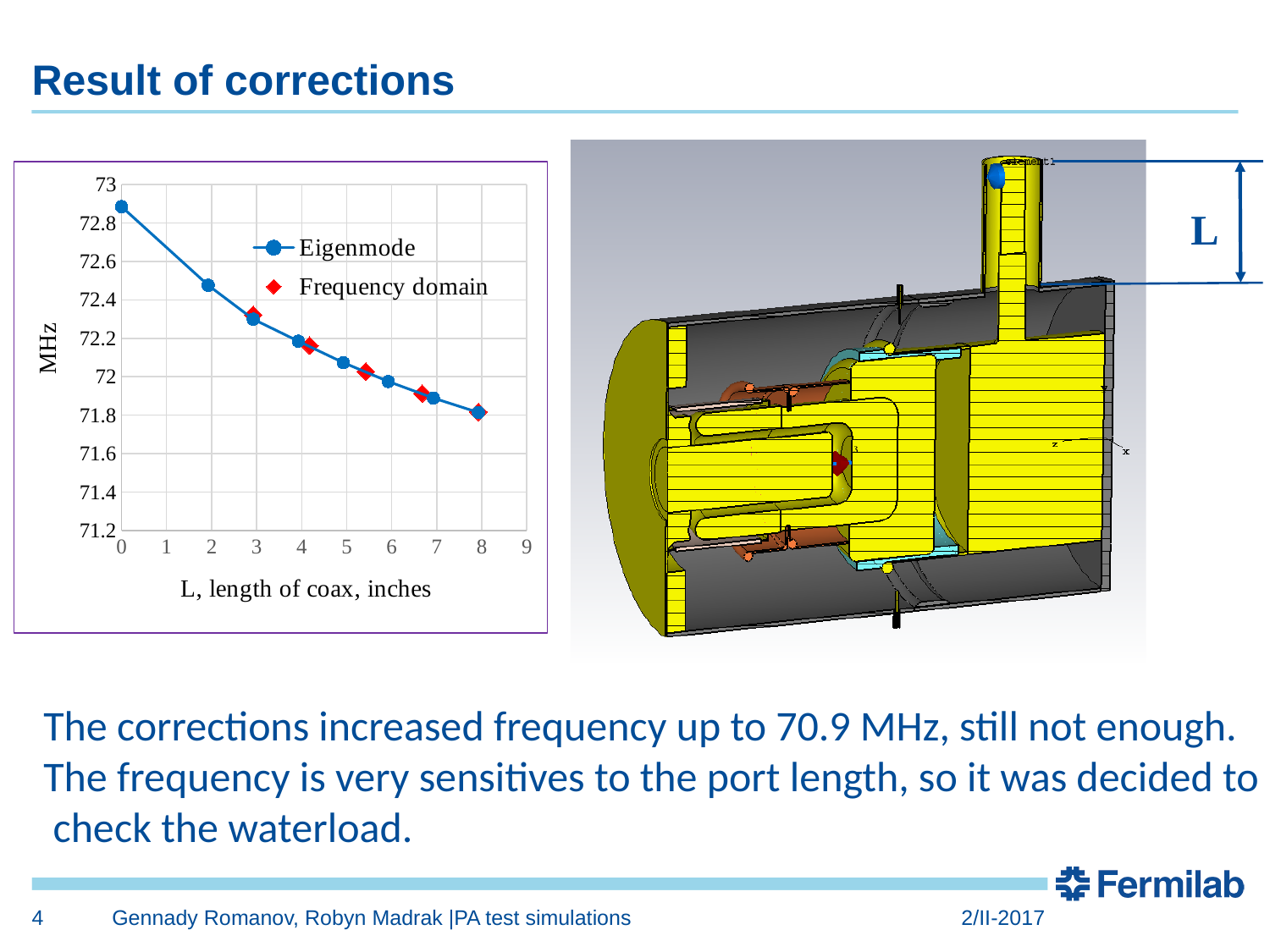
Is the Eigenmode value at L = 6 inches greater or less than 71.8 MHz? greater Which series is plotted with red diamond markers? Frequency domain Is the Eigenmode value at L = 2 inches greater or less than 72.2 MHz? greater What are the two series named in the chart legend? Eigenmode and Frequency domain Is the Eigenmode value at L = 8 inches greater or less than 72 MHz? less Does the Eigenmode frequency rise or fall as L, the length of coax, increases? fall What is the x-axis title of the chart? L, length of coax, inches What kind of chart is shown on the slide? line chart How many series does the chart legend list? 2